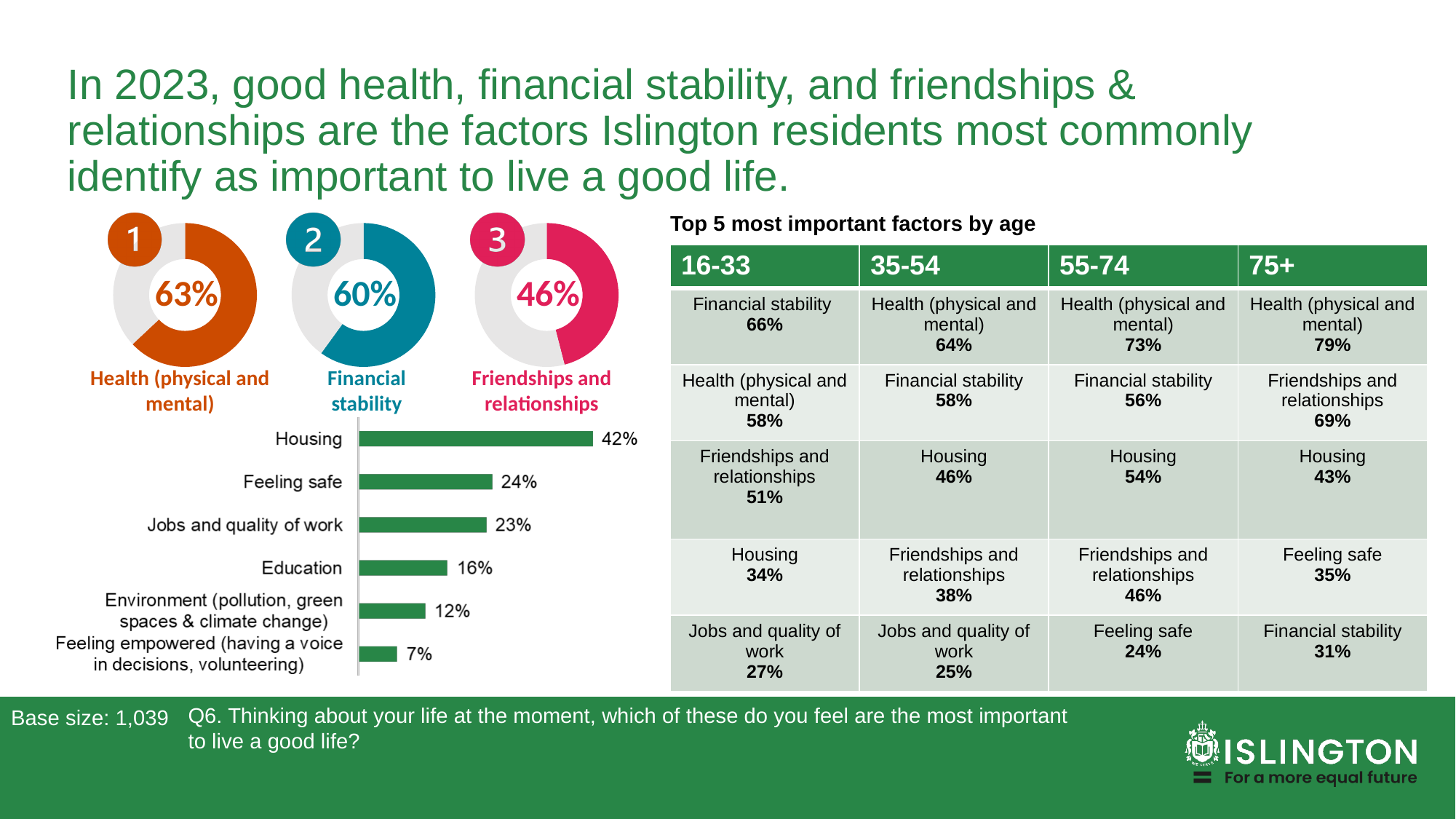
In the horizontal bar chart on the left, which category has the highest value? Housing In the horizontal bar chart on the left, which is larger: Jobs and quality of work or Environment (pollution, green spaces & climate change)? Jobs and quality of work In the donut charts at the top left, what percentage is shown for Health (physical and mental)? 63% In the donut charts at the top left, what is the difference between Health (physical and mental) and Financial stability? 3% What kind of chart is used for Housing, Feeling safe and the other factors on the left of the slide? Bar chart In the horizontal bar chart on the left, what is the value for Feeling safe? 24% In the horizontal bar chart on the left, what is the value for Housing? 42% In the horizontal bar chart on the left, what is the difference between Housing and Feeling safe? 18% In the horizontal bar chart on the left, which category has the lowest value? Feeling empowered (having a voice in decisions, volunteering) How many categories are shown in the horizontal bar chart on the left? 6 In the horizontal bar chart on the left, what is the value for Education? 16% In the donut charts at the top left, what percentage is shown for Friendships and relationships? 46%